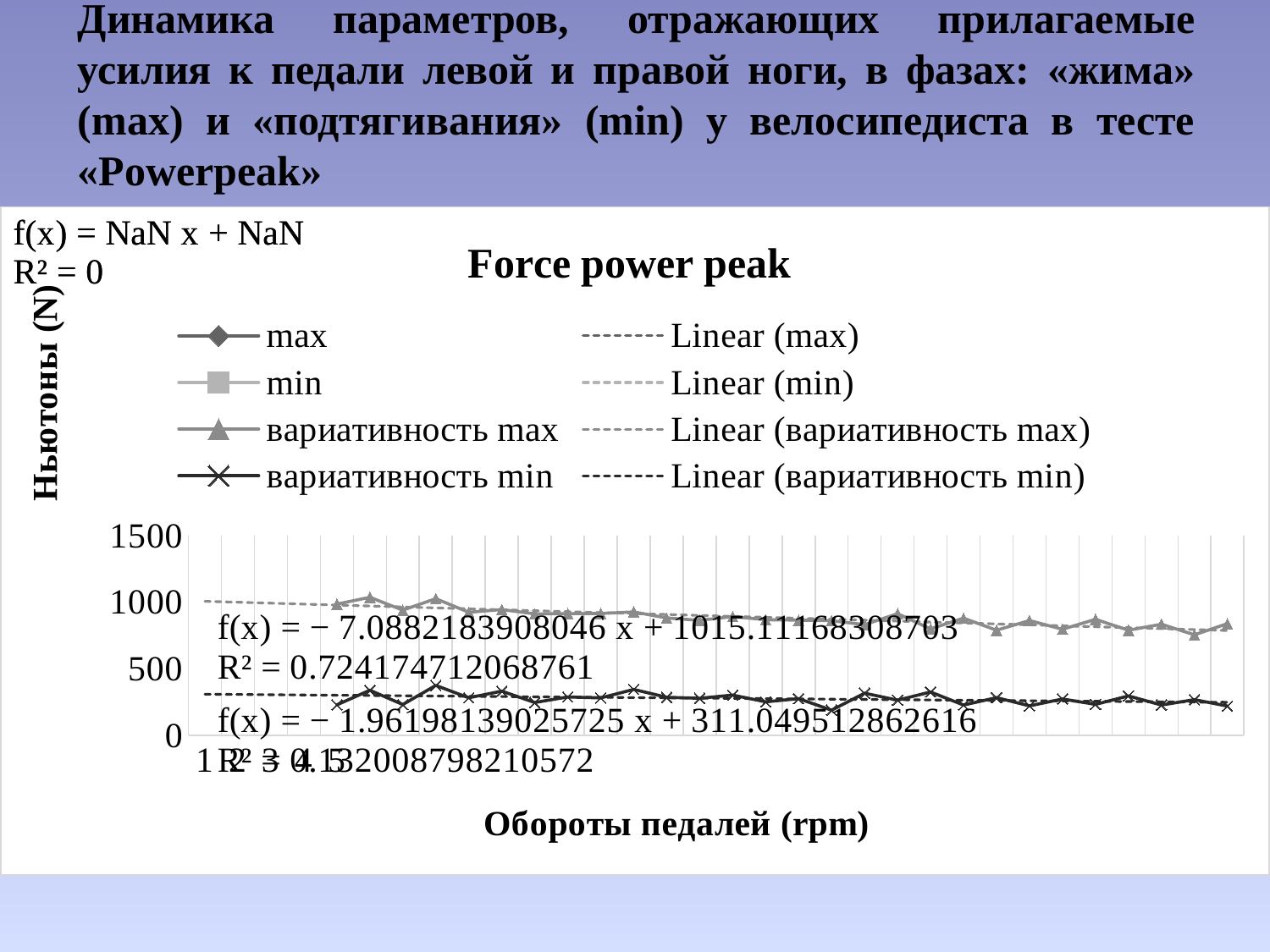
Do the values of the 'вариативность max' series rise or fall along the x axis? fall What is the intercept in the trendline equation f(x) = − 1.96198139025725 x + ... printed on the chart? 311.049512862616 What R² value is printed for the trendline with equation f(x) = − 7.0882183908046 x + 1015.11168308703? 0.724174712068761 Are the values of the 'вариативность min' series greater or less than 500? less Are the values of the 'вариативность max' series greater or less than 500? greater What is the label of the vertical axis of the chart? Ньютоны (N) What kind of chart is shown on the slide? line chart What is the title of the chart? Force power peak How many entries does the chart legend list? 8 Which series is plotted higher on the chart, 'вариативность max' or 'вариативность min'? вариативность max What is the highest tick value shown on the vertical axis? 1500